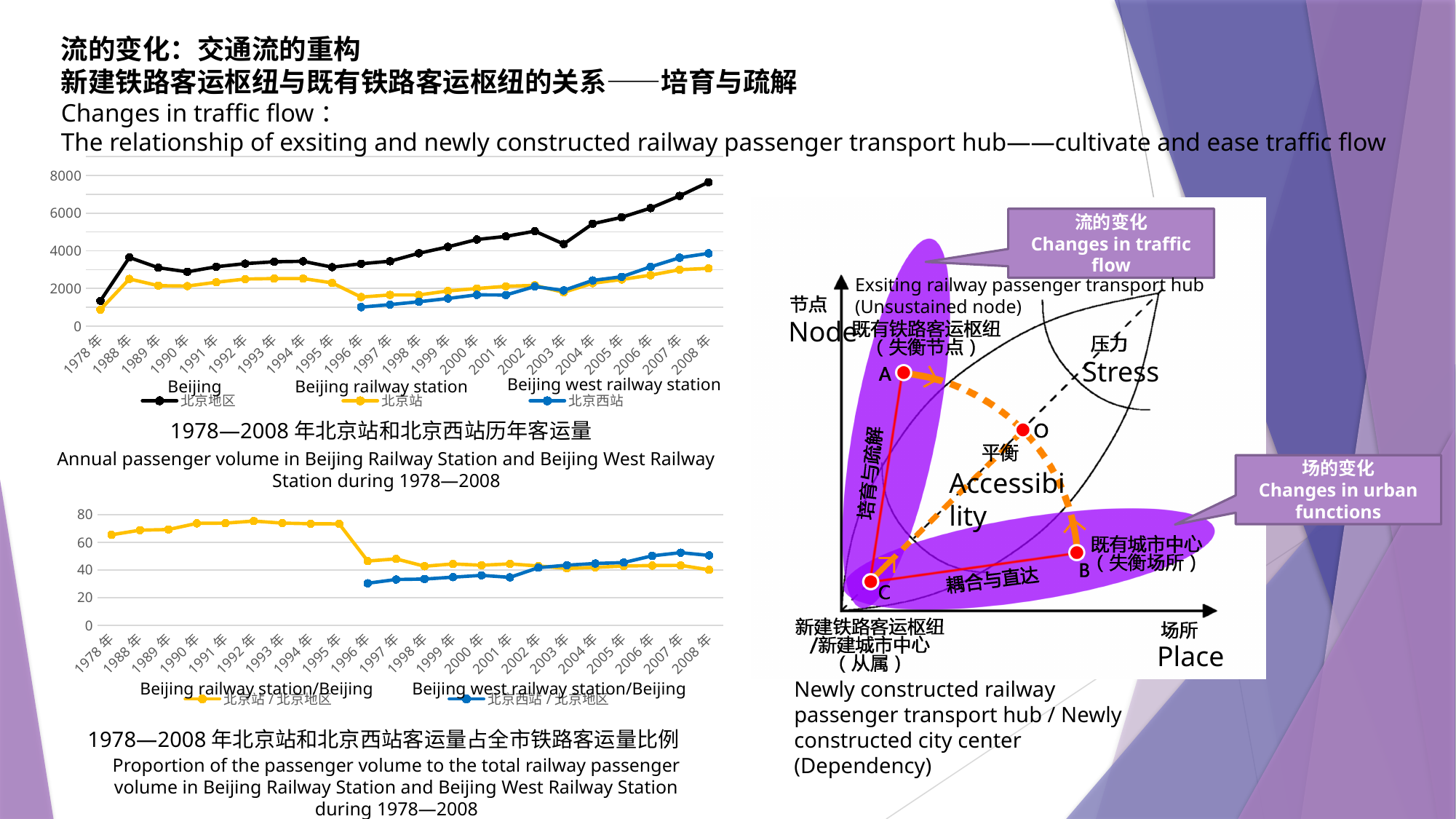
What kind of chart is the top chart, 'Annual passenger volume in Beijing Railway Station and Beijing West Railway Station during 1978—2008'? line chart In the bottom chart (proportion of passenger volume), which is larger in 2008: Beijing railway station/Beijing or Beijing west railway station/Beijing? Beijing west railway station/Beijing In the top chart (annual passenger volume), how many series does the legend list? 3 In the top chart (annual passenger volume), in which year is the Beijing series highest? 2008 In the top chart (annual passenger volume), is the Beijing value for 2008 greater or less than 6000? greater In the bottom chart (proportion of passenger volume), does the Beijing railway station/Beijing series rise or fall from 1995 to 1996? fall In the top chart (annual passenger volume), is the Beijing west railway station value for 1996 greater or less than 2000? less In the top chart (annual passenger volume), is the Beijing value for 1978 greater or less than 2000? less In the bottom chart (proportion of passenger volume), how many series does the legend list? 2 In the top chart (annual passenger volume), which is larger in 2008: Beijing railway station or Beijing west railway station? Beijing west railway station How many years are shown on the x axis of the top chart (annual passenger volume)? 22